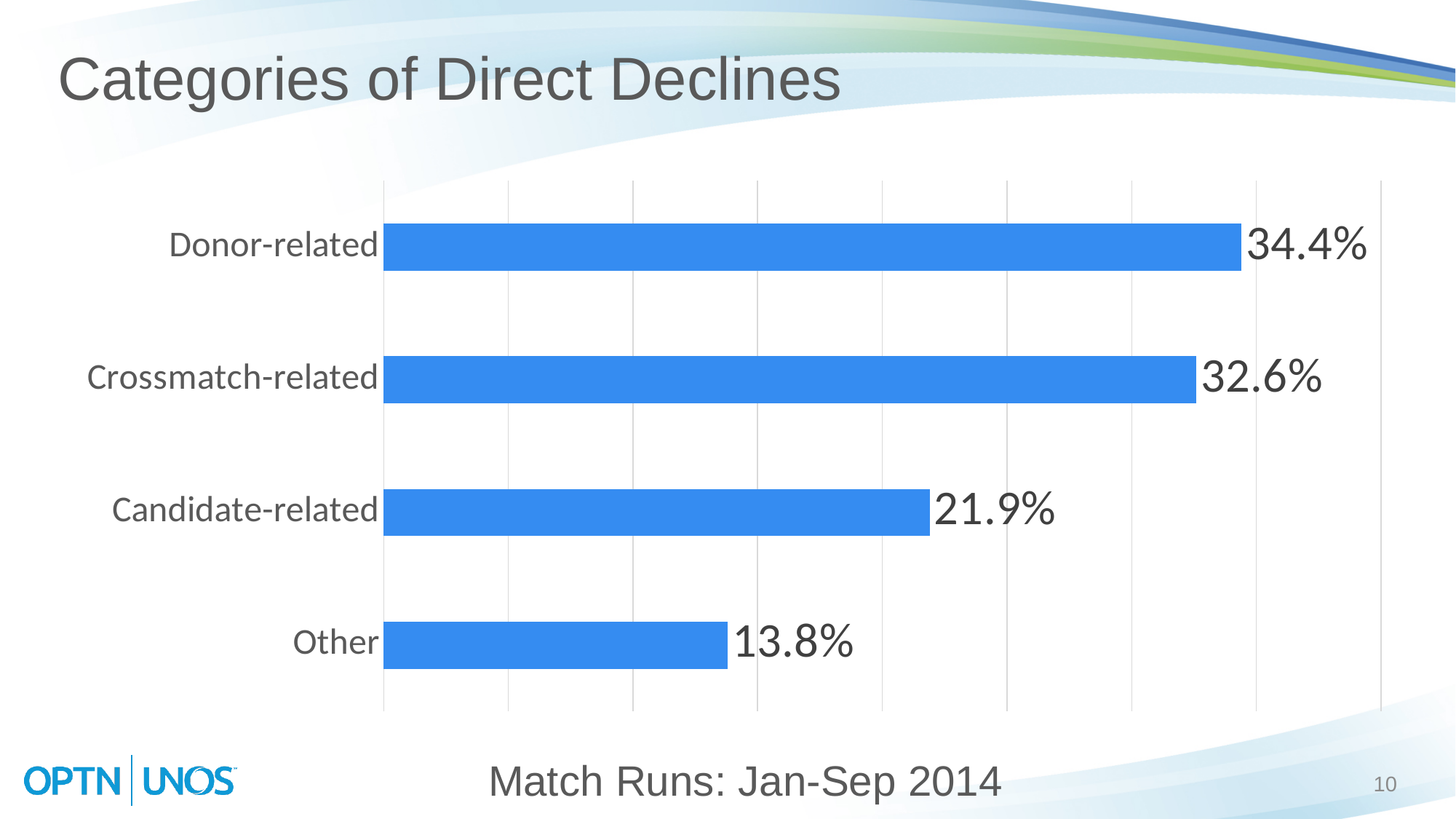
Which is larger, the value for Candidate-related or the value for Other? Candidate-related What is the difference between the Donor-related and Crossmatch-related values? 1.8% What is the value for Other? 13.8% What is the value for Donor-related? 34.4% Which category has the highest value? Donor-related What is the value for Crossmatch-related? 32.6% What is the value for Candidate-related? 21.9% What kind of chart is shown on the slide? Bar chart How many categories are shown in the chart? 4 What is the difference between the Candidate-related and Other values? 8.1% What is the title of the slide containing the chart? Categories of Direct Declines Which category has the lowest value? Other